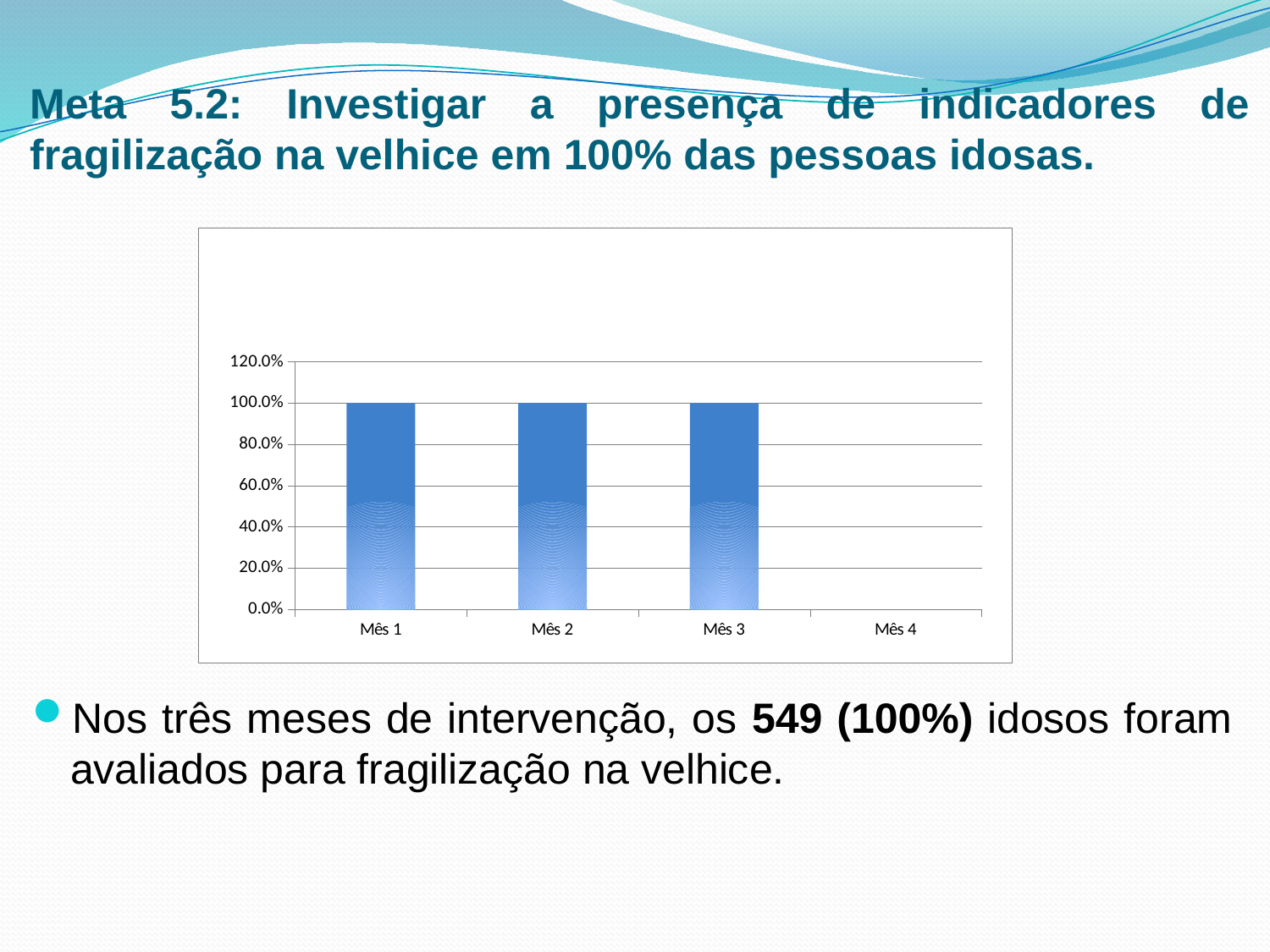
What is the value for Mês 2 in the chart? 100.0% What is the value for Mês 3 in the chart? 100.0% Which category on the x axis has no bar drawn? Mês 4 What kind of chart is shown on the slide? bar chart Which is larger, the value for Mês 1 or the value for Mês 4? Mês 1 How many categories are shown on the x axis of the chart? 4 Which category has the lowest value in the chart? Mês 4 What is the value for Mês 1 in the chart? 100.0% Is the value for Mês 2 greater or less than 80.0%? greater Is the value for Mês 3 greater or less than 120.0%? less What is the highest tick label shown on the y axis of the chart? 120.0% What is the difference between the values for Mês 1 and Mês 3? 0.0%